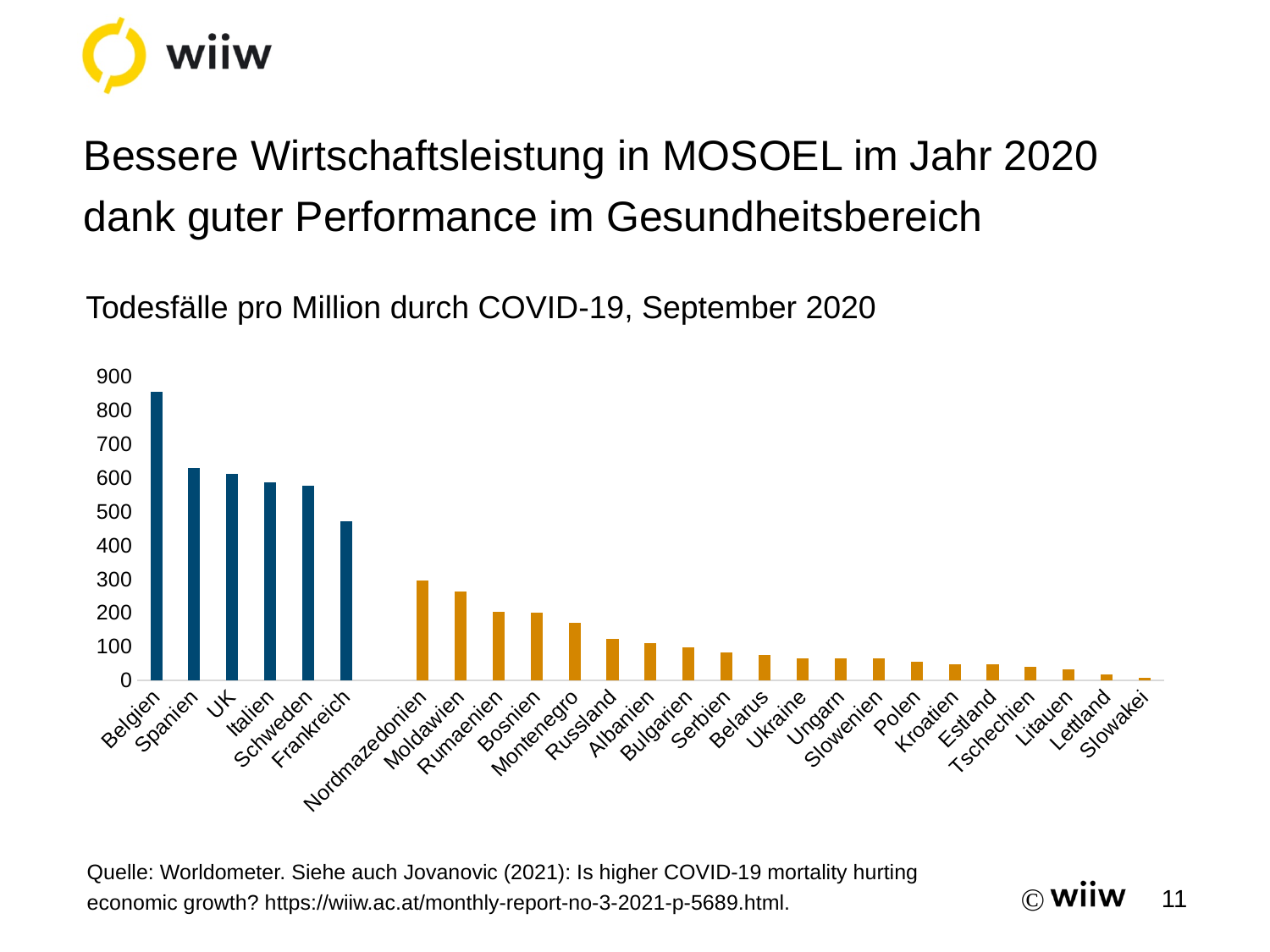
Which country has the lowest number of COVID-19 deaths per million in the chart? Slowakei Do the values generally rise or fall from left to right along the x axis? fall Is the value for Lettland greater or less than 100? less What is the title of the chart? Todesfälle pro Million durch COVID-19, September 2020 Which has a higher value, Nordmazedonien or Russland? Nordmazedonien Is the value for Frankreich greater or less than 500? less How many countries are shown in the chart? 26 Is the value for Spanien greater or less than 600? greater Which country has the highest number of COVID-19 deaths per million in the chart? Belgien What kind of chart is shown on the slide? bar chart